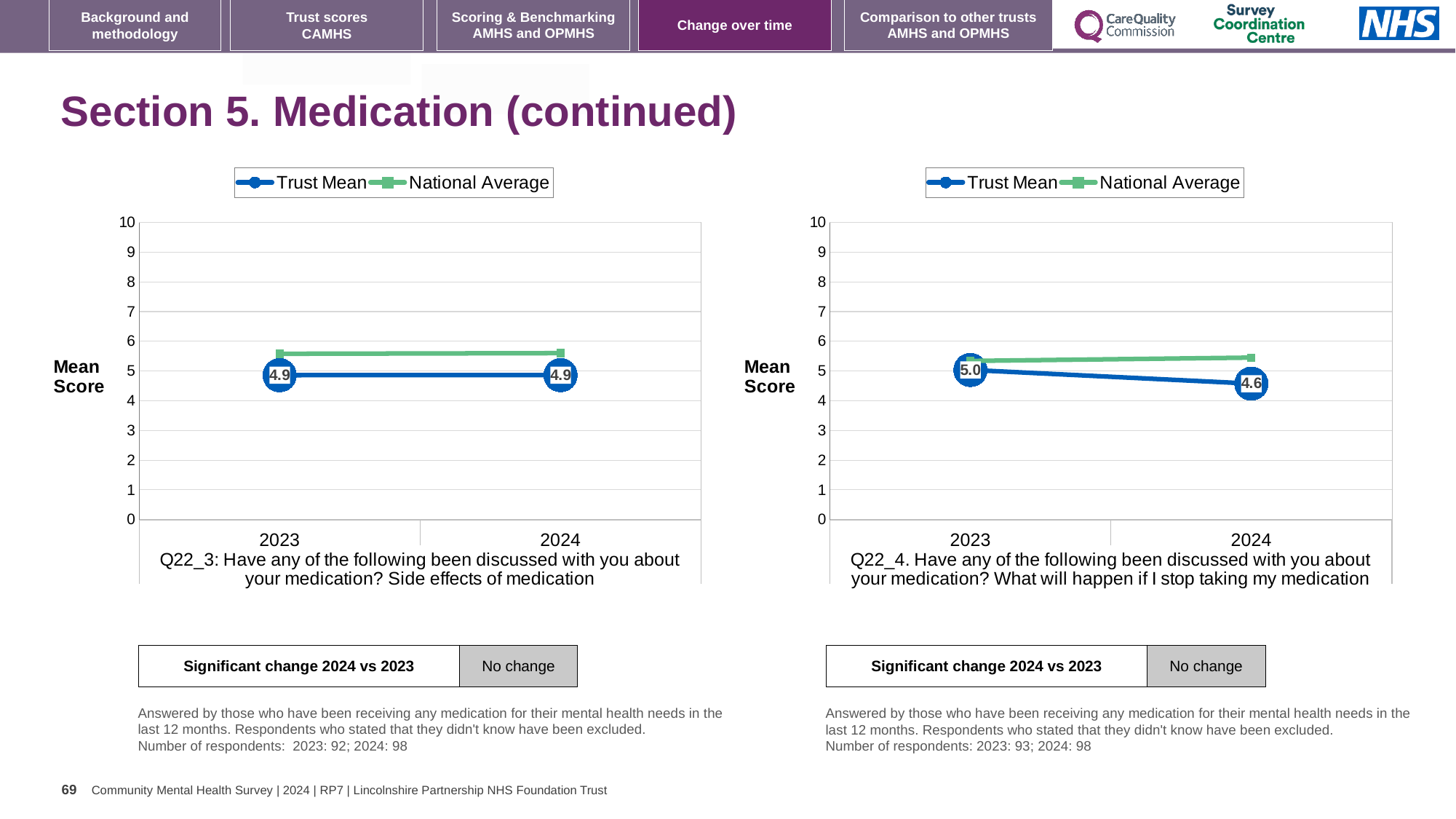
In the right chart (Q22_4), what is the difference between the Trust Mean for 2023 and 2024? 0.4 In the left chart (Q22_3), what is the Trust Mean for 2024? 4.9 In the left chart (Q22_3), is the National Average for 2024 greater or less than 5? greater In the right chart (Q22_4), does the Trust Mean rise or fall from 2023 to 2024? fall In the left chart (Q22_3), what is the Trust Mean for 2023? 4.9 In the right chart (Q22_4), what is the Trust Mean for 2023? 5.0 In the right chart (Q22_4), which year has the higher Trust Mean, 2023 or 2024? 2023 In the right chart (Q22_4), is the National Average for 2024 greater or less than 6? less In the right chart (Q22_4), what is the Trust Mean for 2024? 4.6 How many years are shown on the x axis of the right chart (Q22_4)? 2 What kind of chart is the left chart (Q22_3)? line chart How many series does the legend of the left chart (Q22_3) list? 2